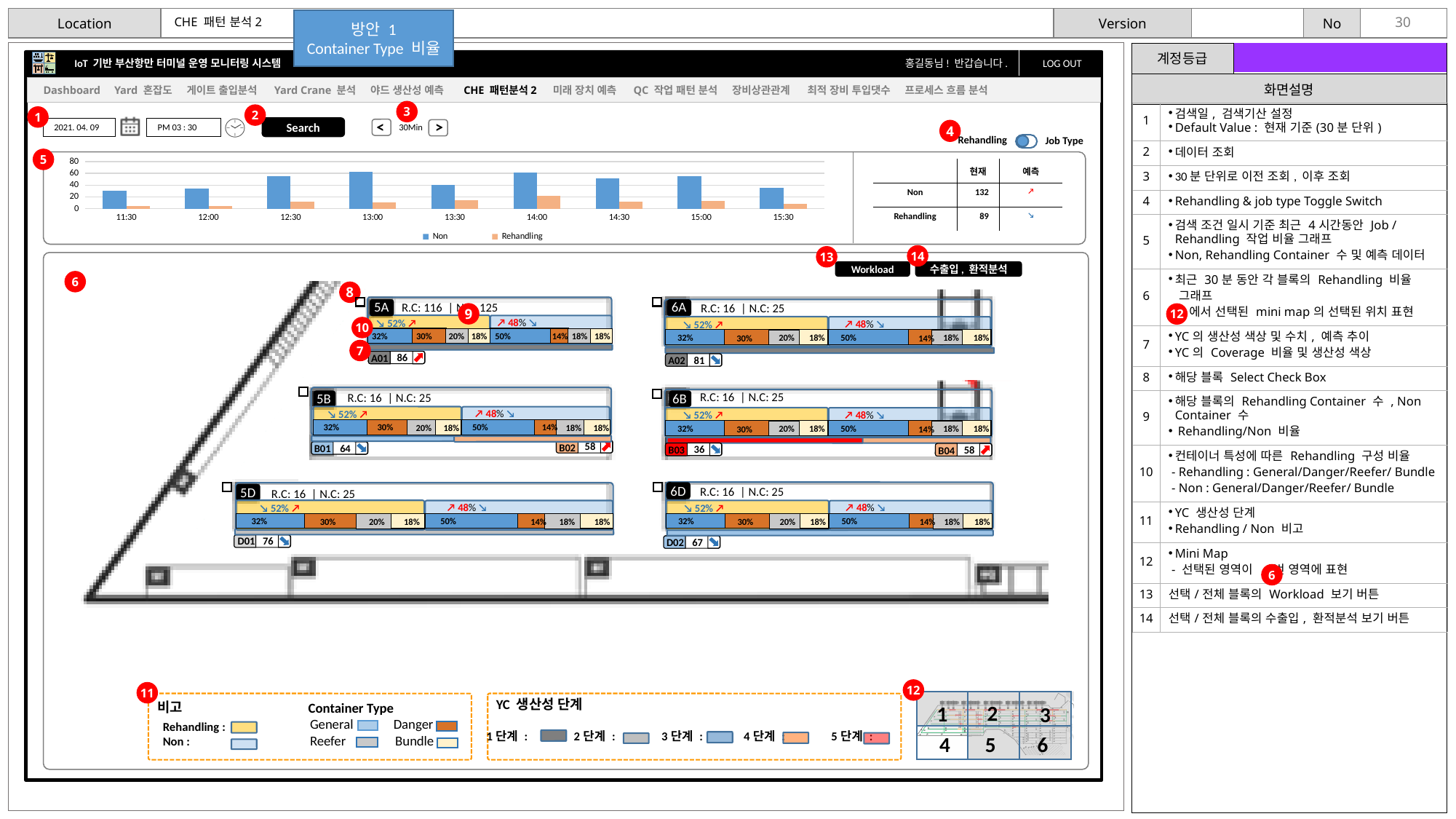
In the top bar chart, which is larger: the Non value at 13:00 or the Non value at 15:30? 13:00 In the top bar chart, is the Non value at 12:30 greater or less than 40? greater In the top bar chart, is the Non value at 13:00 greater or less than 40? greater In the top bar chart, which time has the highest Rehandling value? 14:00 In the top bar chart, is the Non value at 11:30 greater or less than 40? less How many time categories are shown on the x axis of the top bar chart? 9 In the top bar chart legend, which colour represents Rehandling? orange In the top bar chart, which is larger at 14:00: the Non value or the Rehandling value? Non How many series does the legend of the top bar chart list? 2 In the table to the right of the top bar chart, what is the 현재 value for Non? 132 What kind of chart is shown in the top panel (item 5) of the dashboard? bar chart